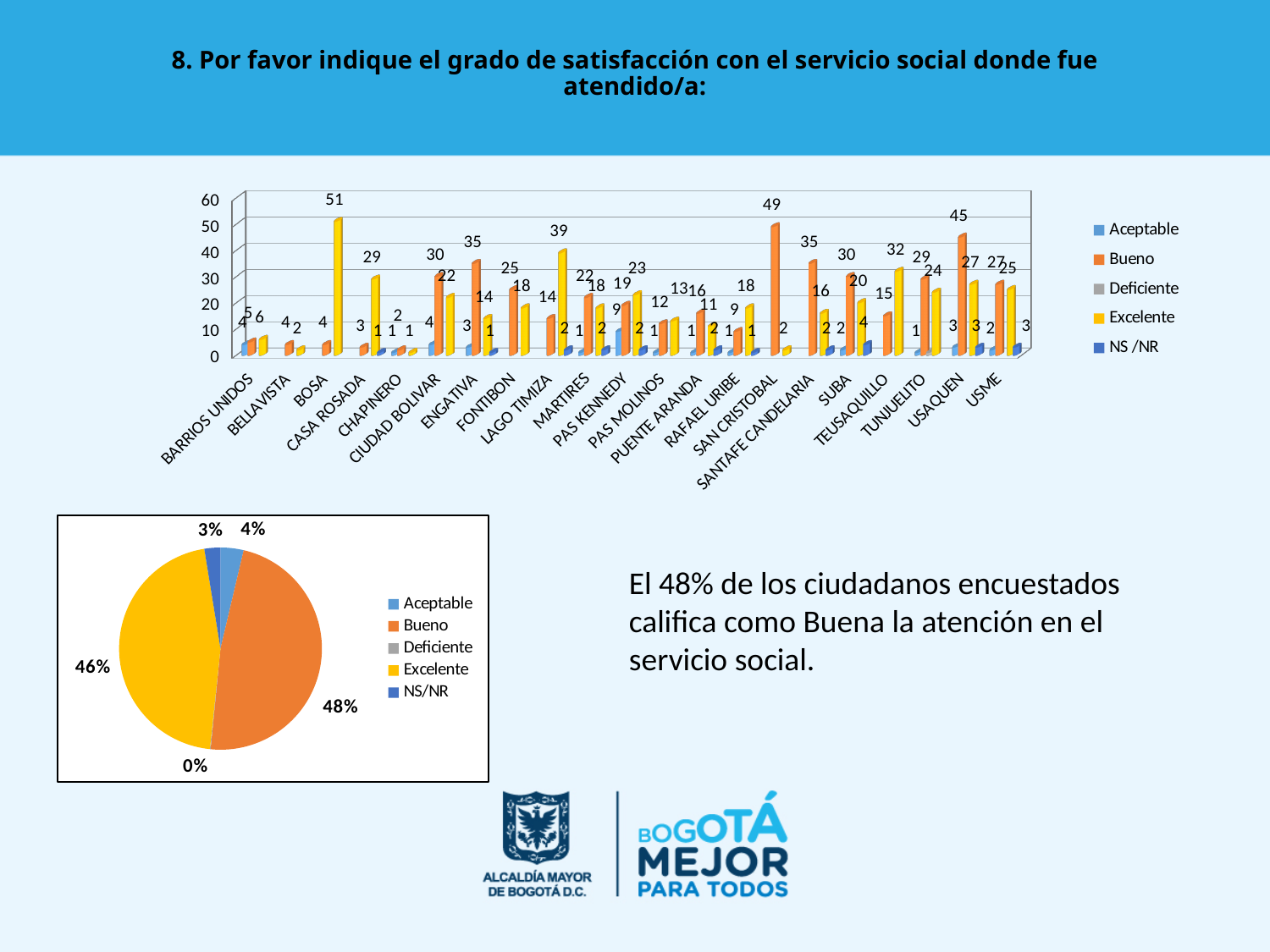
How many localities (categories) are shown on the x axis of the top bar chart? 21 In the top bar chart, what is the Excelente value for BOSA? 51 In the top bar chart, which is larger: the Bueno value for USAQUEN or the Bueno value for SAN CRISTOBAL? SAN CRISTOBAL In the pie chart, what percentage is shown for Deficiente? 0% In the pie chart, what share of respondents rated the service as Bueno? 48% In the pie chart, what percentage is shown for NS/NR? 3% In the top bar chart, what is the Bueno value for SAN CRISTOBAL? 49 What kind of chart is the top chart on the slide? Bar chart In the pie chart, how many percentage points larger is the Bueno slice than the Excelente slice? 2 In the pie chart, what share of respondents rated the service as Excelente? 46% How many series does the legend of the top bar chart list? 5 In the pie chart, which category has the largest slice? Bueno